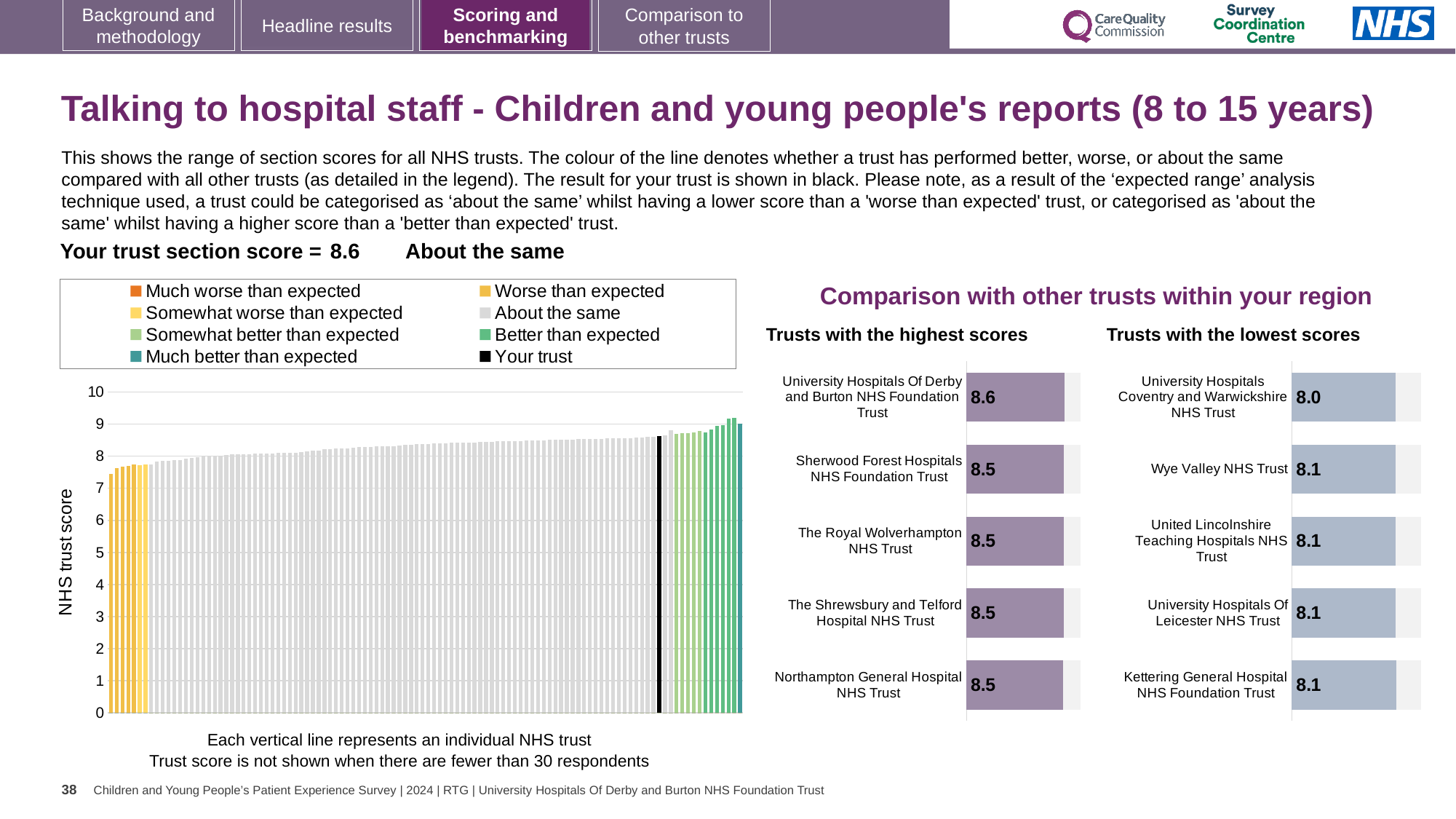
In the large chart on the left showing all NHS trusts, do the bar values rise or fall from left to right? rise In the 'Trusts with the lowest scores' chart, what is the score for Kettering General Hospital NHS Foundation Trust? 8.1 In the 'Trusts with the lowest scores' chart, which trust has the lowest score? University Hospitals Coventry and Warwickshire NHS Trust In the 'Trusts with the highest scores' chart, which trust has the highest score? University Hospitals Of Derby and Burton NHS Foundation Trust How many trusts are shown in the 'Trusts with the lowest scores' chart? 5 Which is larger: the score for Sherwood Forest Hospitals NHS Foundation Trust in the 'Trusts with the highest scores' chart or the score for Wye Valley NHS Trust in the 'Trusts with the lowest scores' chart? Sherwood Forest Hospitals NHS Foundation Trust In the 'Trusts with the lowest scores' chart, what is the score for University Hospitals Coventry and Warwickshire NHS Trust? 8.0 In the 'Trusts with the highest scores' chart, what is the score for Northampton General Hospital NHS Trust? 8.5 What is the difference between the score for University Hospitals Of Derby and Burton NHS Foundation Trust in the 'Trusts with the highest scores' chart and the score for University Hospitals Coventry and Warwickshire NHS Trust in the 'Trusts with the lowest scores' chart? 0.6 In the large chart on the left showing all NHS trusts, is the value for the black 'Your trust' bar greater or less than 8? greater In the 'Trusts with the highest scores' chart, what is the score for University Hospitals Of Derby and Burton NHS Foundation Trust? 8.6 How many entries does the legend above the large chart on the left list? 8